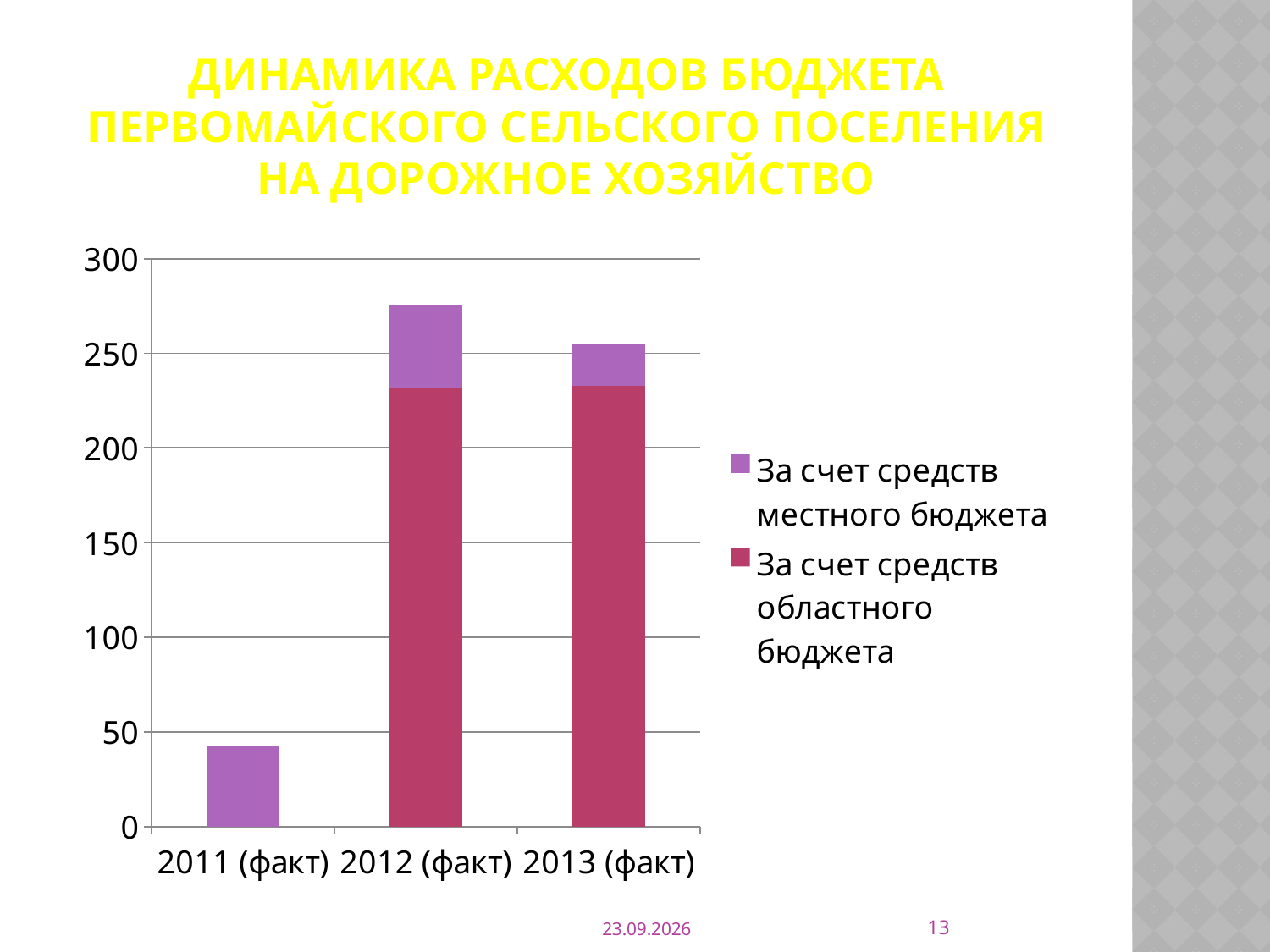
Which series is shown in purple in the chart? За счет средств местного бюджета Which year has the tallest stacked bar? 2012 (факт) Is the total value for 2012 (факт) greater or less than 250? greater Which year has the shortest stacked bar? 2011 (факт) Which is larger: the total for 2012 (факт) or the total for 2013 (факт)? 2012 (факт) Is the total value for 2013 (факт) greater or less than 300? less What kind of chart is shown on the slide? Stacked bar chart How many series does the legend list? 2 Is the value for 'За счет средств областного бюджета' in 2013 (факт) greater or less than 200? greater How many categories are shown on the x axis of the chart? 3 Which year has no 'За счет средств областного бюджета' segment in its bar? 2011 (факт)